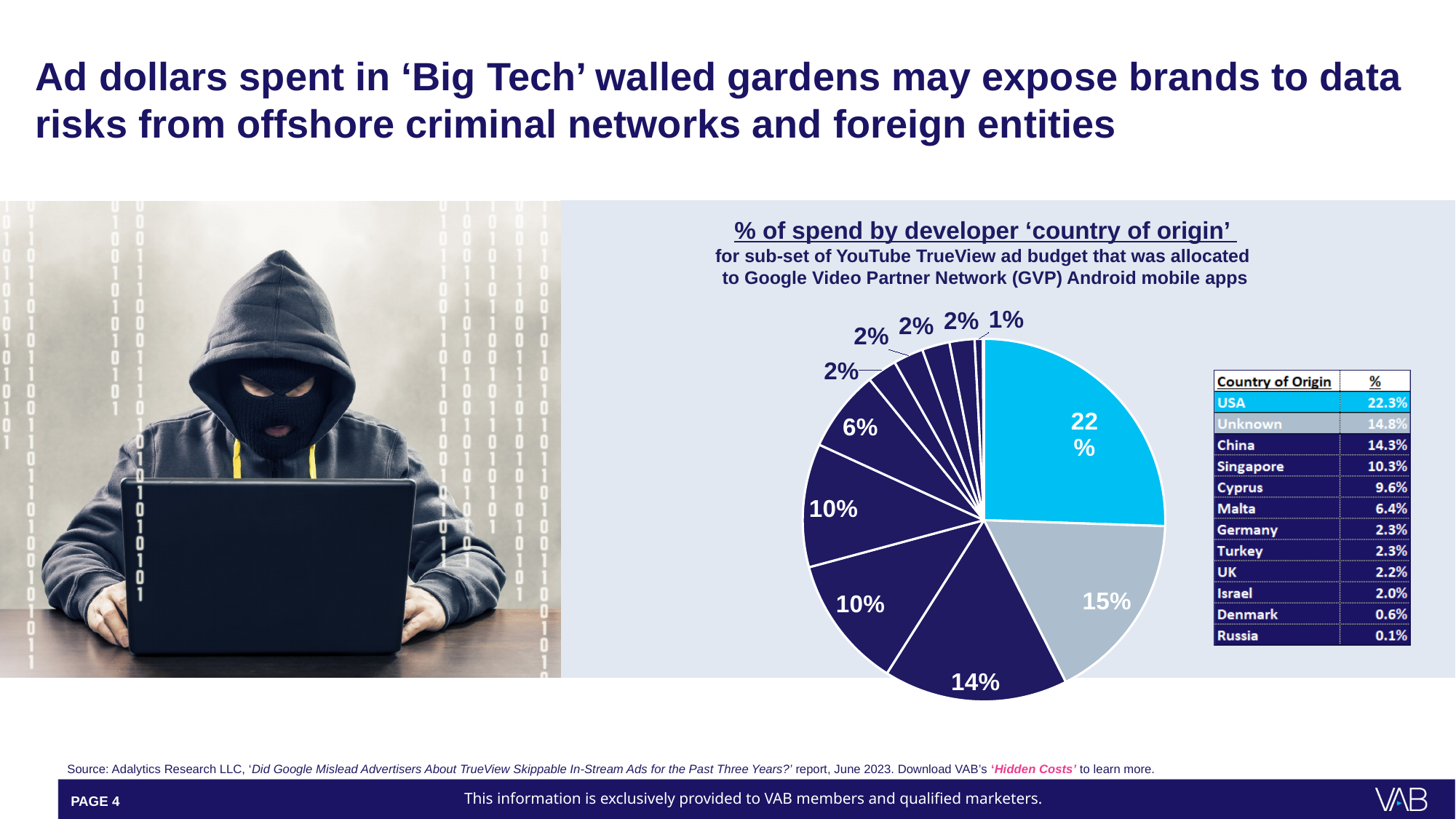
What kind of chart is shown on the slide? pie chart Is the share of spend for Unknown greater or less than 10%? greater Which country of origin has the largest share of spend? USA What is the title of the pie chart? % of spend by developer 'country of origin' What is the difference in percentage points between USA (22.3%) and Unknown (14.8%) in the table? 7.5 How many countries of origin are listed in the table next to the pie chart? 12 According to the table, what percentage of spend is attributed to Singapore? 10.3% What share of the pie is labelled for the USA slice? 22% According to the table, what percentage of spend is attributed to China? 14.3% Which has a larger share of spend, Cyprus or Malta? Cyprus Which country of origin has the smallest share of spend in the table? Russia According to the table, what percentage of spend is attributed to Germany? 2.3%